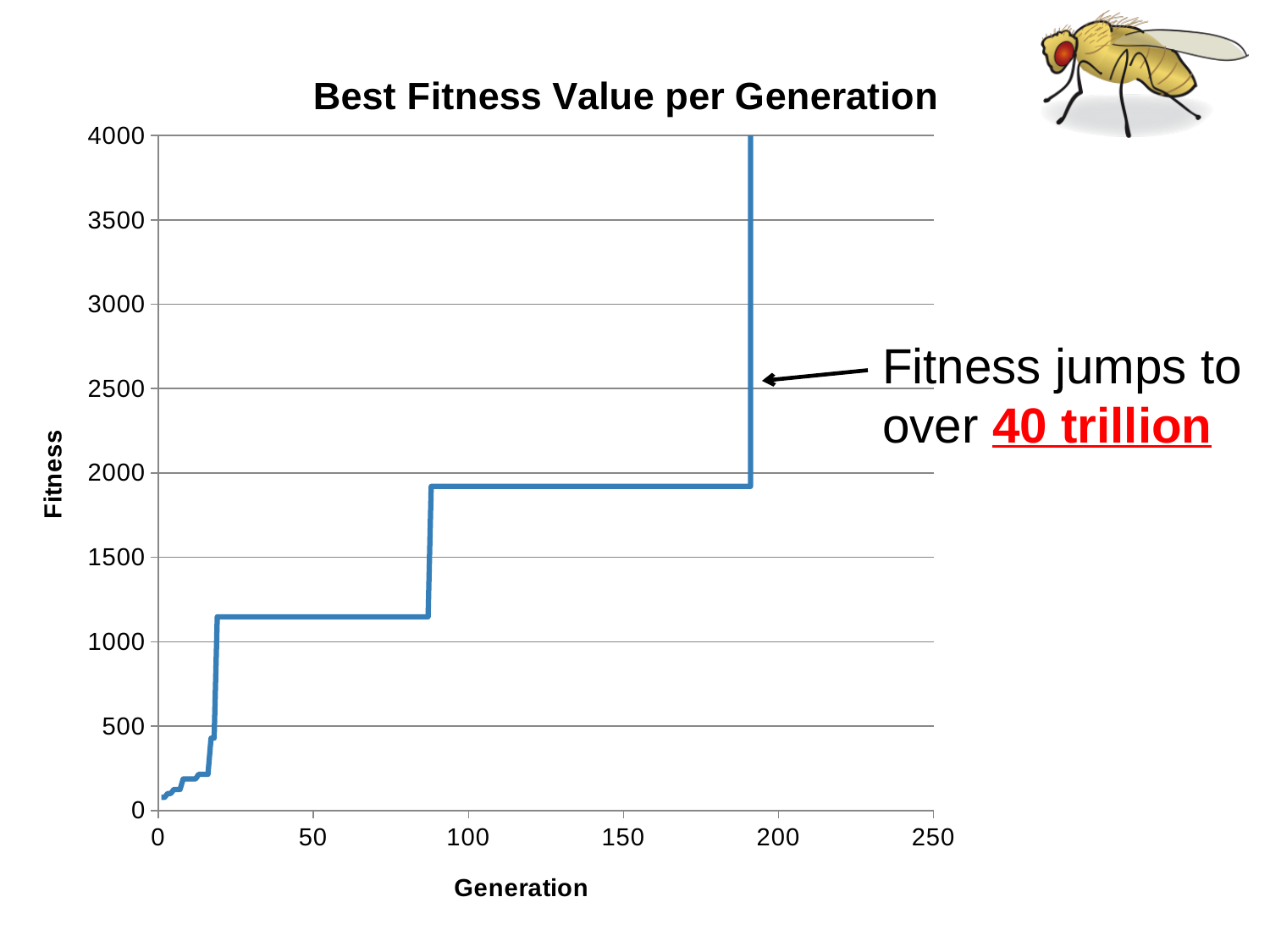
Is the fitness value at generation 150 greater or less than 2000? less Is the fitness value at generation 150 greater or less than 1500? greater Is the fitness value at generation 50 greater or less than 1500? less What type of chart is shown on the slide? line chart Does the fitness value rise or fall as the generation increases? rise What is the label of the x axis? Generation Which is larger, the fitness value at generation 50 or at generation 150? generation 150 What is the title of the chart? Best Fitness Value per Generation What is the highest value shown on the Fitness axis? 4000